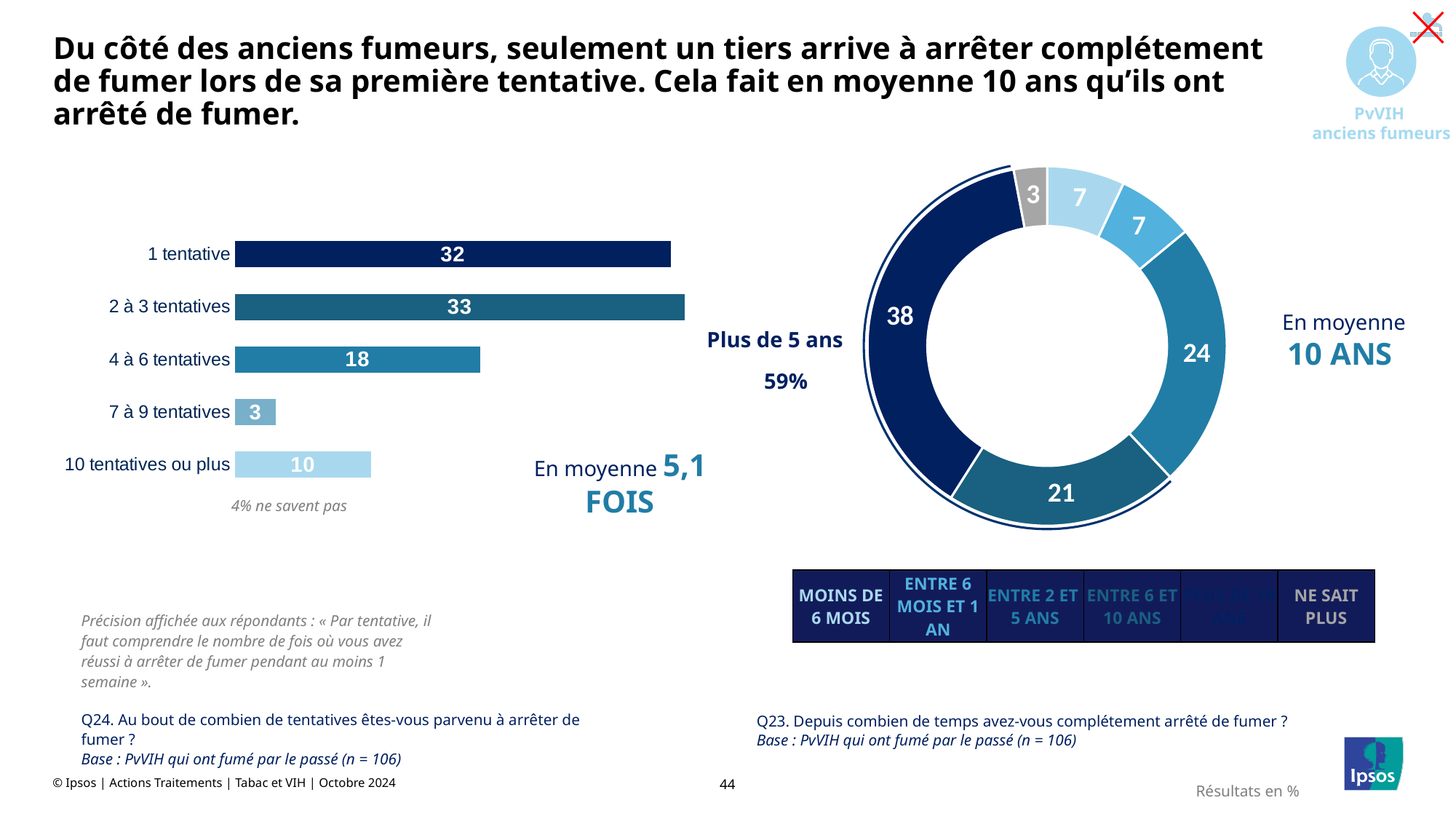
On the right donut chart, what share is labelled 'Plus de 5 ans'? 59% On the left bar chart, which is larger: '4 à 6 tentatives' or '10 tentatives ou plus'? 4 à 6 tentatives On the left bar chart, what is the value for '10 tentatives ou plus'? 10 What kind of chart is shown on the right of the slide? Donut chart On the left bar chart, what is the difference between '1 tentative' and '4 à 6 tentatives'? 14 On the left bar chart, which category has the highest value? 2 à 3 tentatives How many categories does the left bar chart show? 5 What average number of attempts is stated next to the left bar chart? 5,1 fois What kind of chart is shown on the left of the slide? Bar chart On the left bar chart, what is the value for '2 à 3 tentatives'? 33 On the left bar chart, which category has the lowest value? 7 à 9 tentatives On the right donut chart, what is the largest segment value? 38